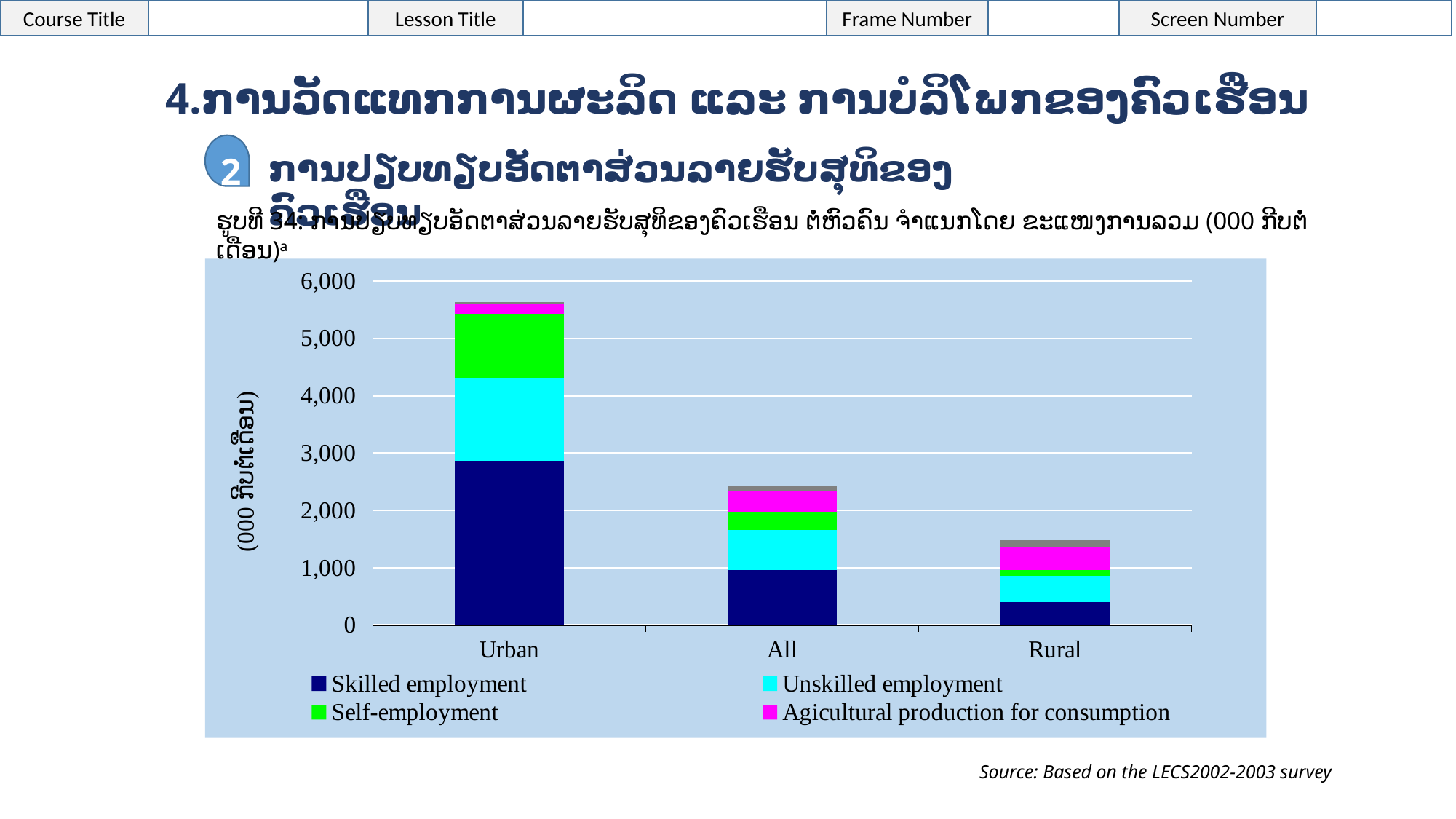
Which category has the shortest stacked bar? Rural How many categories are shown on the x axis of the chart? 3 Is the total value of the Urban bar greater or less than 5,000? greater Is the total value of the All bar greater or less than 2,000? greater Is the Skilled employment value for Rural greater or less than 1,000? less Which colour represents Self-employment in the legend? Green How many series does the chart's legend list? 4 What kind of chart is shown on the slide? Stacked bar chart Which category has the tallest stacked bar? Urban Which has the larger Skilled employment value, Urban or Rural? Urban Do the total bar heights rise or fall moving from Urban to Rural along the x axis? fall